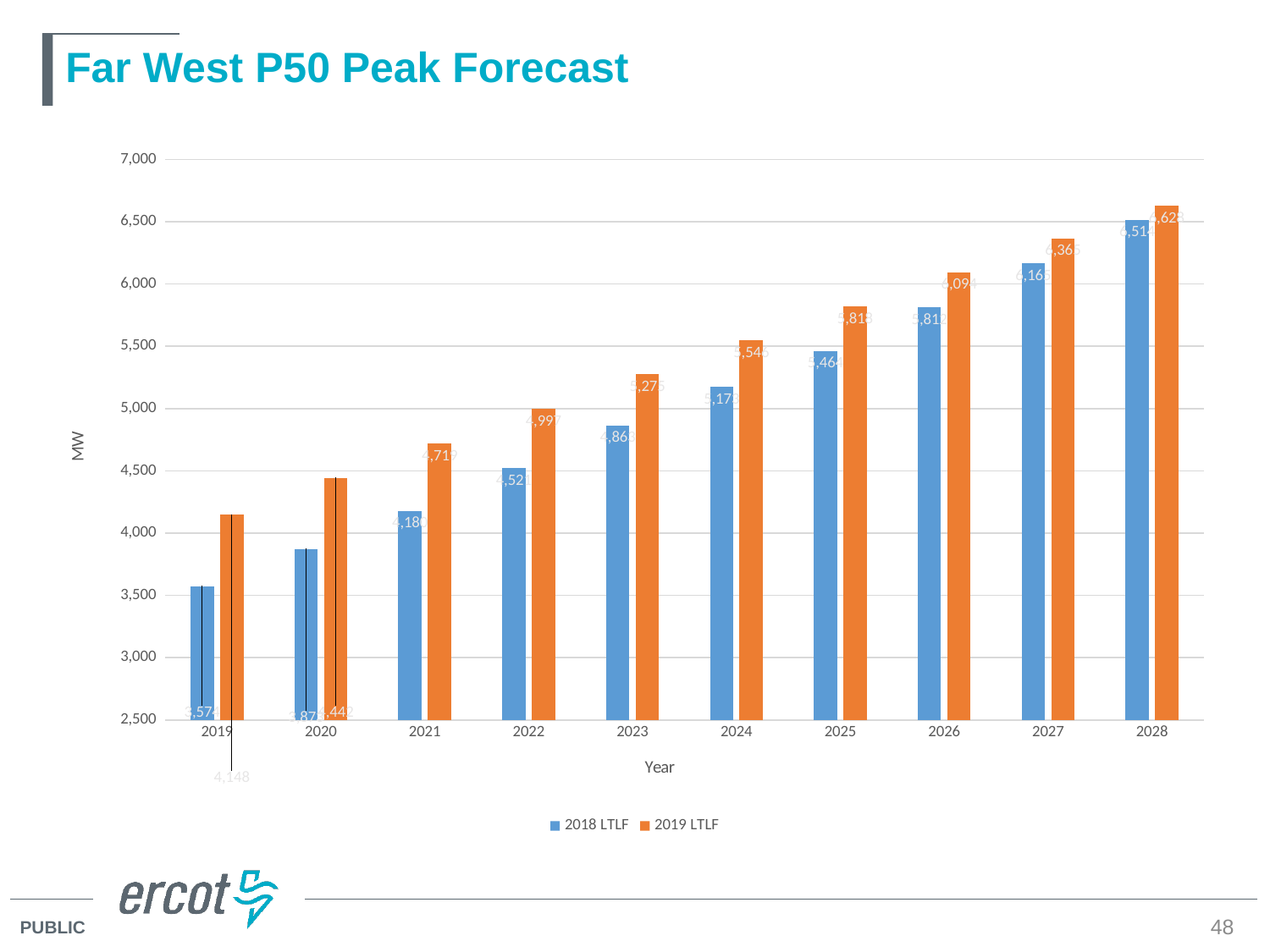
Which year has the lowest 2018 LTLF value? 2019 Which year has the highest 2019 LTLF value? 2028 How many series does the legend list? 2 For 2019, which series has the larger value, 2018 LTLF or 2019 LTLF? 2019 LTLF What kind of chart is shown on the slide? bar chart How many years are shown on the x axis? 10 Is the 2019 LTLF value for 2028 greater or less than 6,500? greater What is the 2019 LTLF value for 2019? 4,148 Is the 2018 LTLF value for 2026 greater or less than 6,000? less Do the 2018 LTLF values rise or fall from 2019 to 2028? rise Is the 2019 LTLF value for 2021 greater or less than 4,500? greater What is the label on the y axis? MW